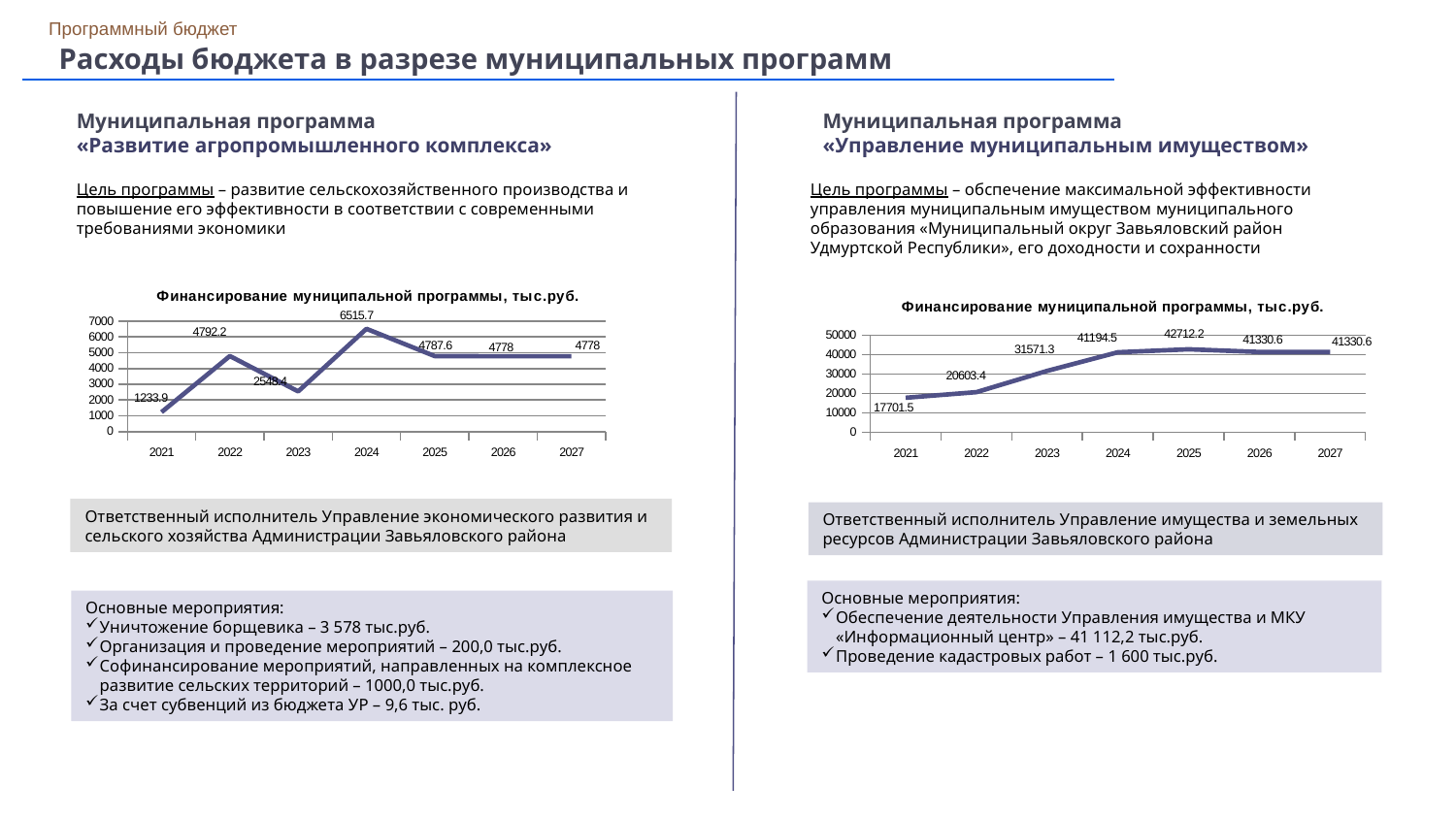
On the right chart (Управление муниципальным имуществом), do the values rise or fall from 2021 to 2024? Rise On the left chart (Развитие агропромышленного комплекса), what is the difference between the 2024 value and the 2023 value? 3967.3 On the right chart (Управление муниципальным имуществом), which year has the highest value? 2025 On the right chart (Управление муниципальным имуществом), is the value for 2022 larger or smaller than the value for 2023? Smaller On the left chart (Развитие агропромышленного комплекса), what is the value for 2021? 1233.9 On the right chart (Управление муниципальным имуществом), what is the value for 2021? 17701.5 On the left chart (Развитие агропромышленного комплекса), which year has the lowest value? 2021 On the left chart (Развитие агропромышленного комплекса), which year has the highest value? 2024 On the left chart (Развитие агропромышленного комплекса), what is the value for 2024? 6515.7 On the right chart (Управление муниципальным имуществом), what is the value for 2025? 42712.2 On the left chart (Развитие агропромышленного комплекса), how many years are plotted? 7 What type of chart is used on the left (Развитие агропромышленного комплекса)? Line chart